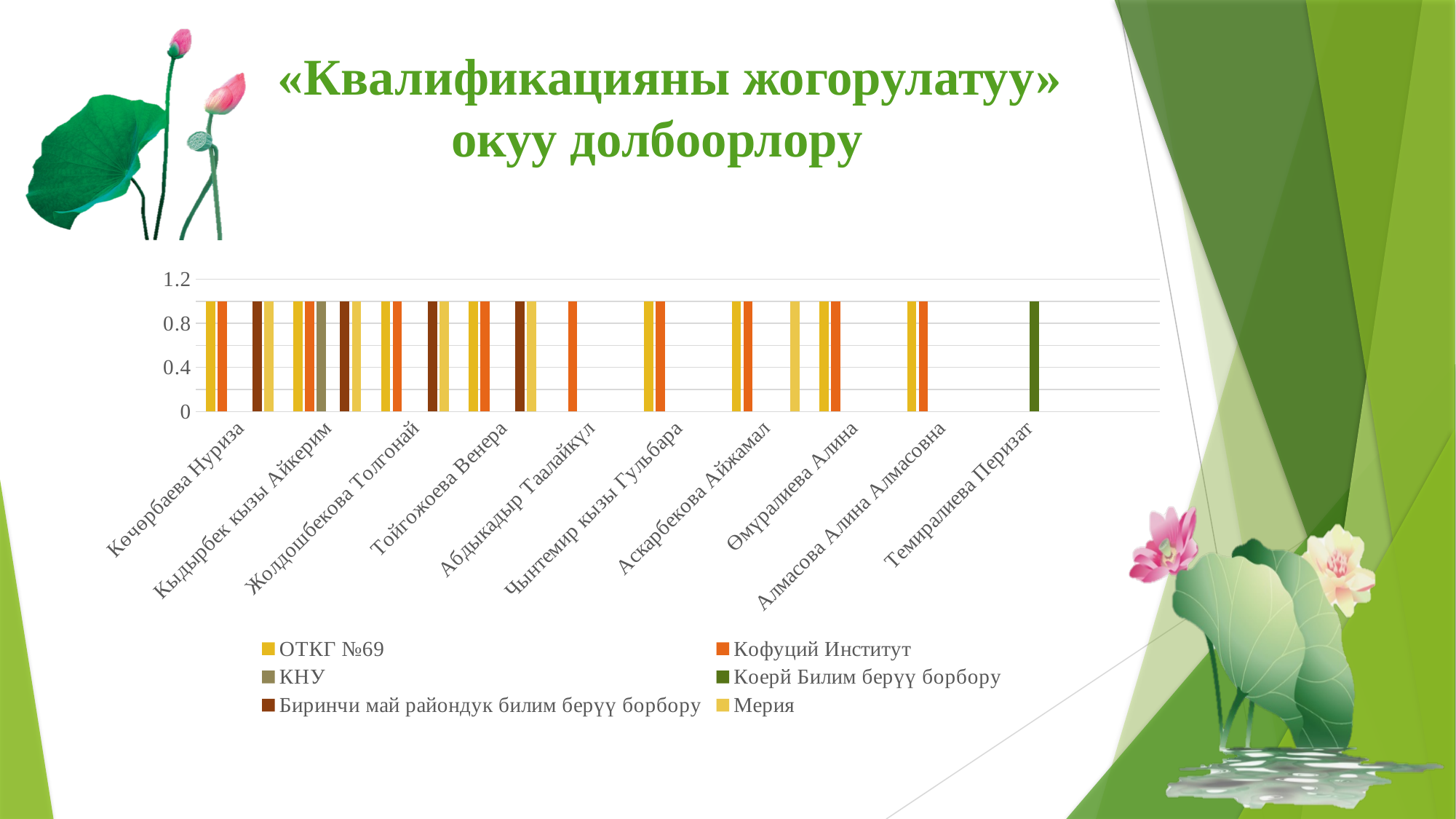
Which legend entry is shown in dark green? Коерй Билим берүү борбору Is the value of the Коерй Билим берүү борбору bar greater or less than 1.2? less What kind of chart is shown on the slide? bar chart Is the value of the КНУ bar greater or less than 0.4? greater Which category label appears last (rightmost) on the horizontal axis? Темиралиева Перизат How many series does the legend list? 6 Which category label appears first (leftmost) on the horizontal axis? Көчөрбаева Нуриза Is the value of the Коерй Билим берүү борбору bar greater or less than 0.8? greater What is the highest value shown on the vertical axis? 1.2